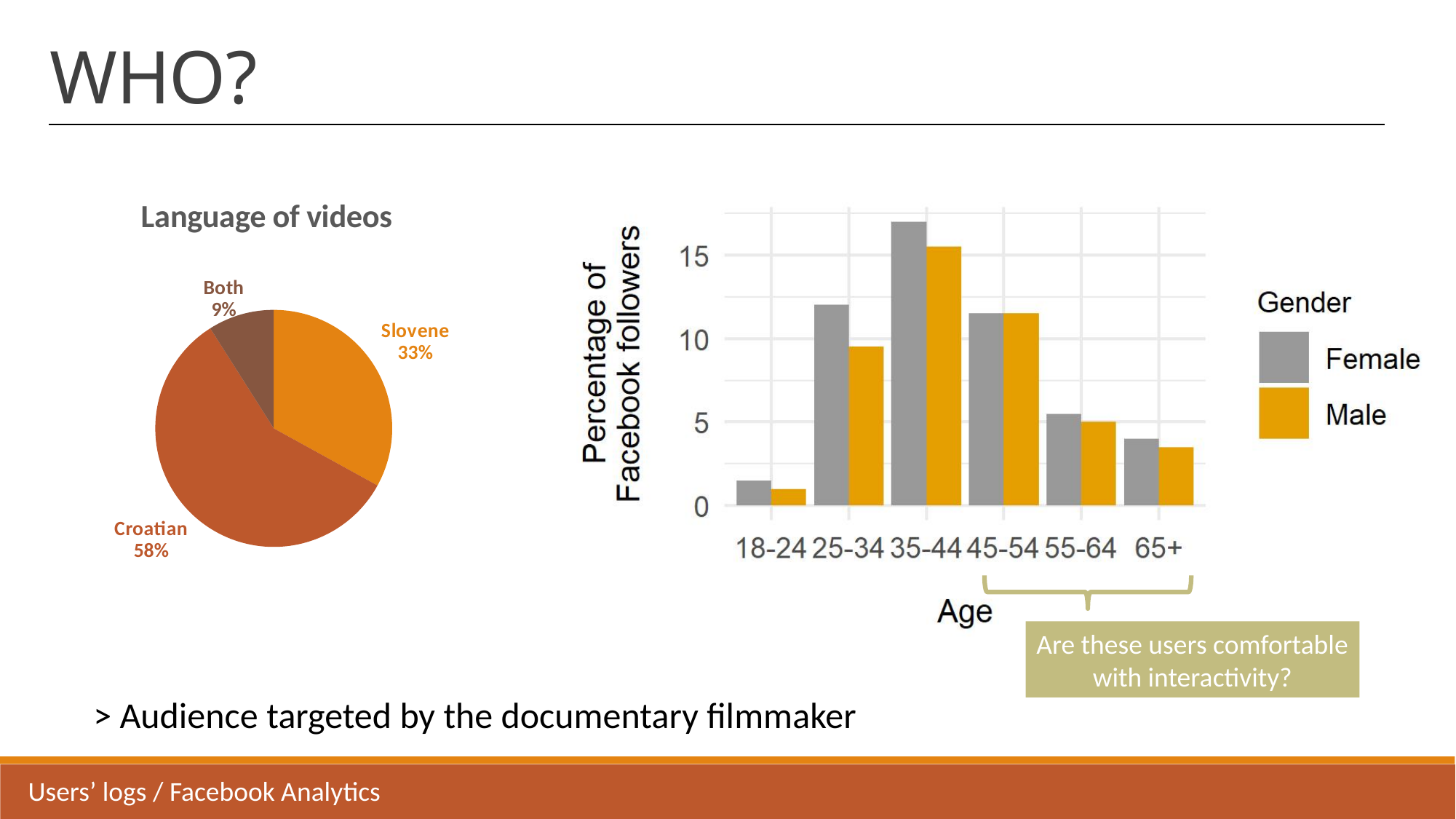
On the 'Language of videos' pie chart, what is the difference in percentage points between Croatian and Slovene? 25 On the 'Language of videos' pie chart, which category has the smallest slice? Both On the bar chart of Facebook followers by age, is the Female value for 25-34 greater or less than 10? greater On the 'Language of videos' pie chart, what share of videos are in Croatian? 58% On the 'Language of videos' pie chart, what percentage is labelled 'Both'? 9% How many slices does the 'Language of videos' pie chart have? 3 On the bar chart of Facebook followers by age, is the Female value for 65+ greater or less than 5? less On the bar chart of Facebook followers by age, which age group has the lowest percentage of Male followers? 18-24 What kind of chart is the chart on the right showing percentage of Facebook followers by age? Bar chart On the bar chart of Facebook followers by age, how many series does the Gender legend list? 2 On the 'Language of videos' pie chart, which language has the largest slice? Croatian On the bar chart of Facebook followers by age, which age group has the highest percentage of Female followers? 35-44